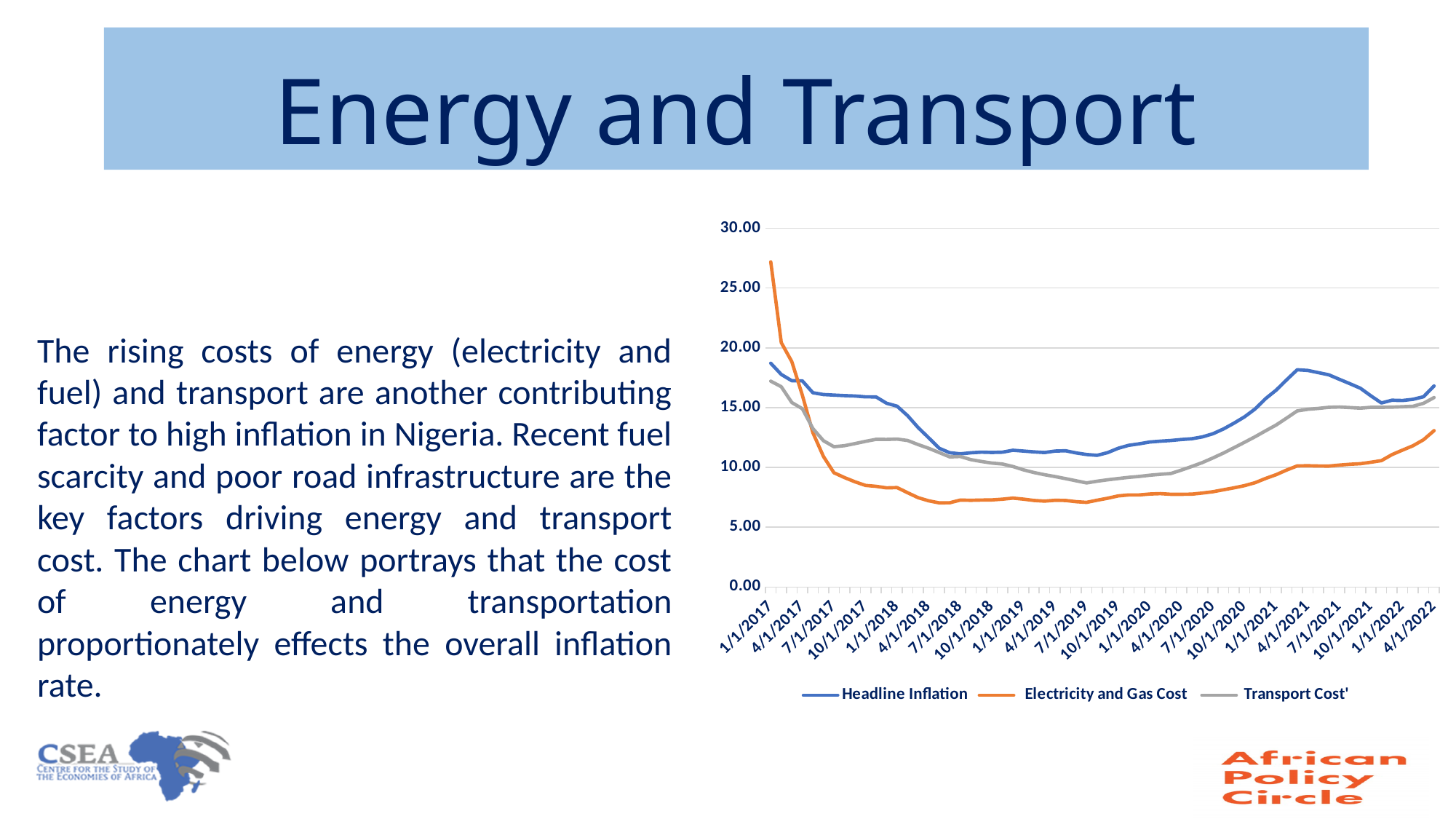
Is the value of Headline Inflation at 4/1/2021 greater or less than 15.00? greater Does Electricity and Gas Cost rise or fall between 1/1/2017 and 7/1/2018? Fall What colour is the Electricity and Gas Cost line in the chart? Orange Is the value of Transport Cost' at 7/1/2019 greater or less than 10.00? less Is the value of Electricity and Gas Cost at 1/1/2017 greater or less than 25.00? greater What kind of chart is shown on the slide? Line chart How many dates are labelled along the x axis of the chart? 22 At 1/1/2017, which series has the highest value? Electricity and Gas Cost How many series does the chart's legend list? 3 At 7/1/2019, which is larger: Headline Inflation or Electricity and Gas Cost? Headline Inflation At 4/1/2022, which series has the lowest value? Electricity and Gas Cost